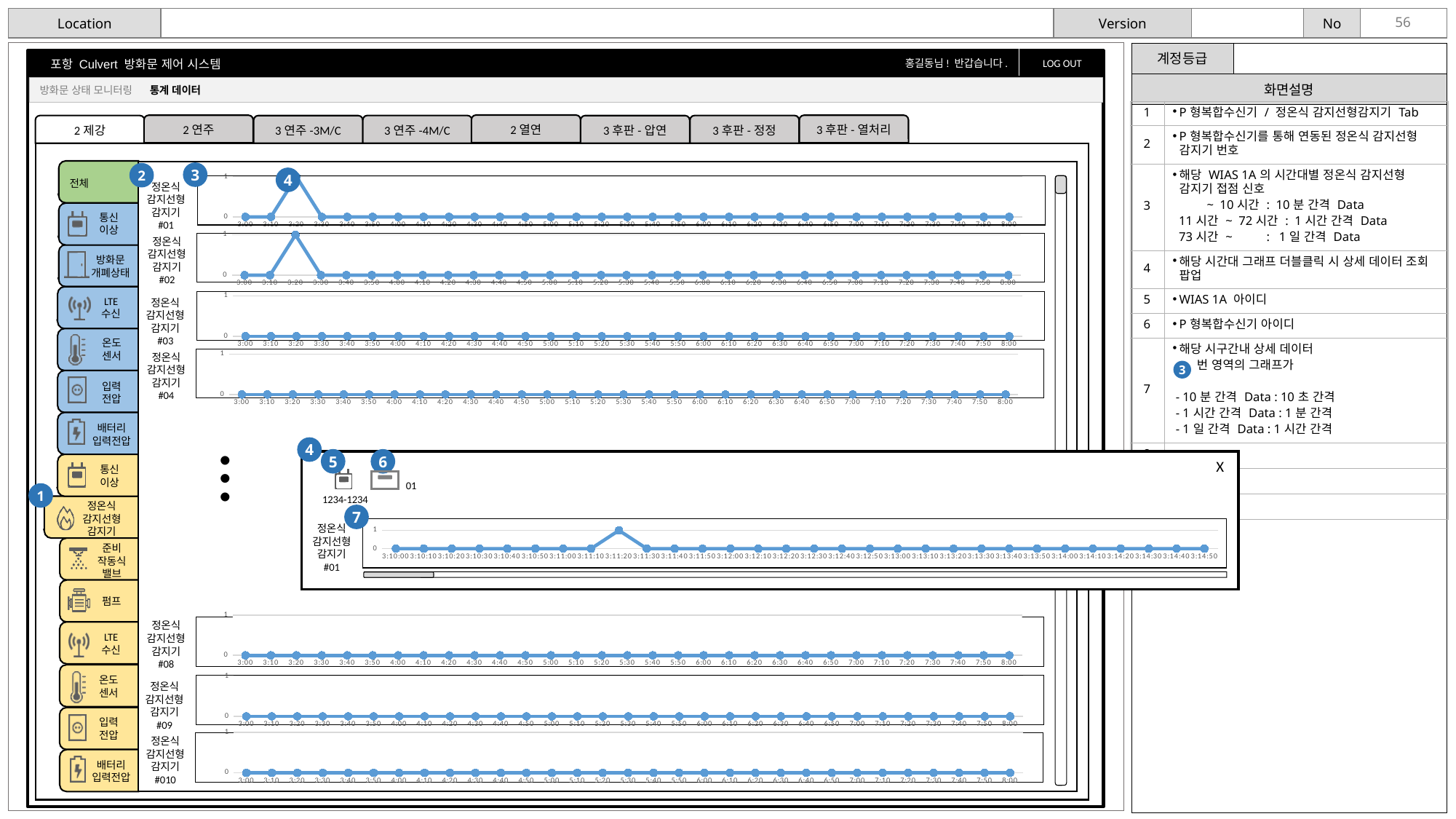
In the main-panel chart for 정온식 감지선형 감지기 #01, what is the value at 3:20? 1 Does the value in the chart for 정온식 감지선형 감지기 #08 rise, fall, or stay flat from 3:00 to 8:00? stay flat What is the highest y-axis tick shown on the chart for 정온식 감지선형 감지기 #04? 1 In the main-panel chart for 정온식 감지선형 감지기 #01, what is the difference between the value at 3:20 and the value at 3:00? 1 In the chart for 정온식 감지선형 감지기 #03, what is the value at 3:00? 0 What kind of chart is used for 정온식 감지선형 감지기 #01 in the main panel? line chart In the main-panel chart for 정온식 감지선형 감지기 #01, at which time is the value highest? 3:20 What is the first x-axis tick label on the chart for 정온식 감지선형 감지기 #09? 3:00 In the chart for 정온식 감지선형 감지기 #02, what is the value at 3:20? 1 In the popup chart for 정온식 감지선형 감지기 #01, what is the value at 3:10:00? 0 In the popup chart for 정온식 감지선형 감지기 #01, at which time does the value reach 1? 3:11:20 In the main-panel chart for 정온식 감지선형 감지기 #01, which is larger: the value at 3:20 or the value at 3:30? 3:20